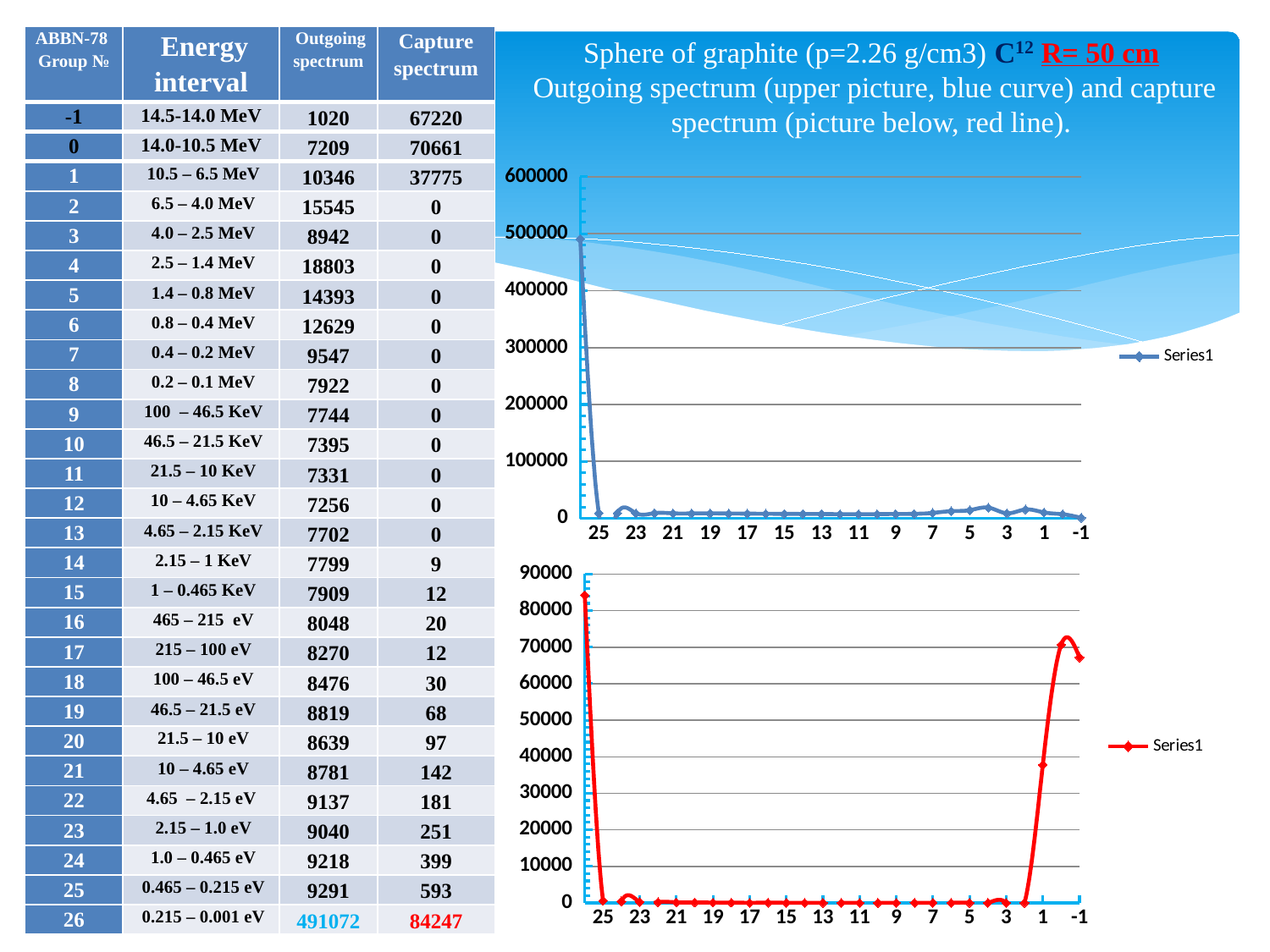
In the lower chart, is the value at x = 2 greater or less than 40000? less In the upper chart, is the value at x = 25 greater or less than 400000? less In the upper chart, how many series does the legend list? 1 In the lower chart, which is larger: the value at x = 25 or the value at x = 1? x = 1 What kind of chart is the upper chart on the slide? line chart What colour is the line in the lower chart? red What kind of chart is the lower chart on the slide? line chart In the lower chart, is the value at x = 25 greater or less than 80000? less In the lower chart, what is the name of the series shown in the legend? Series1